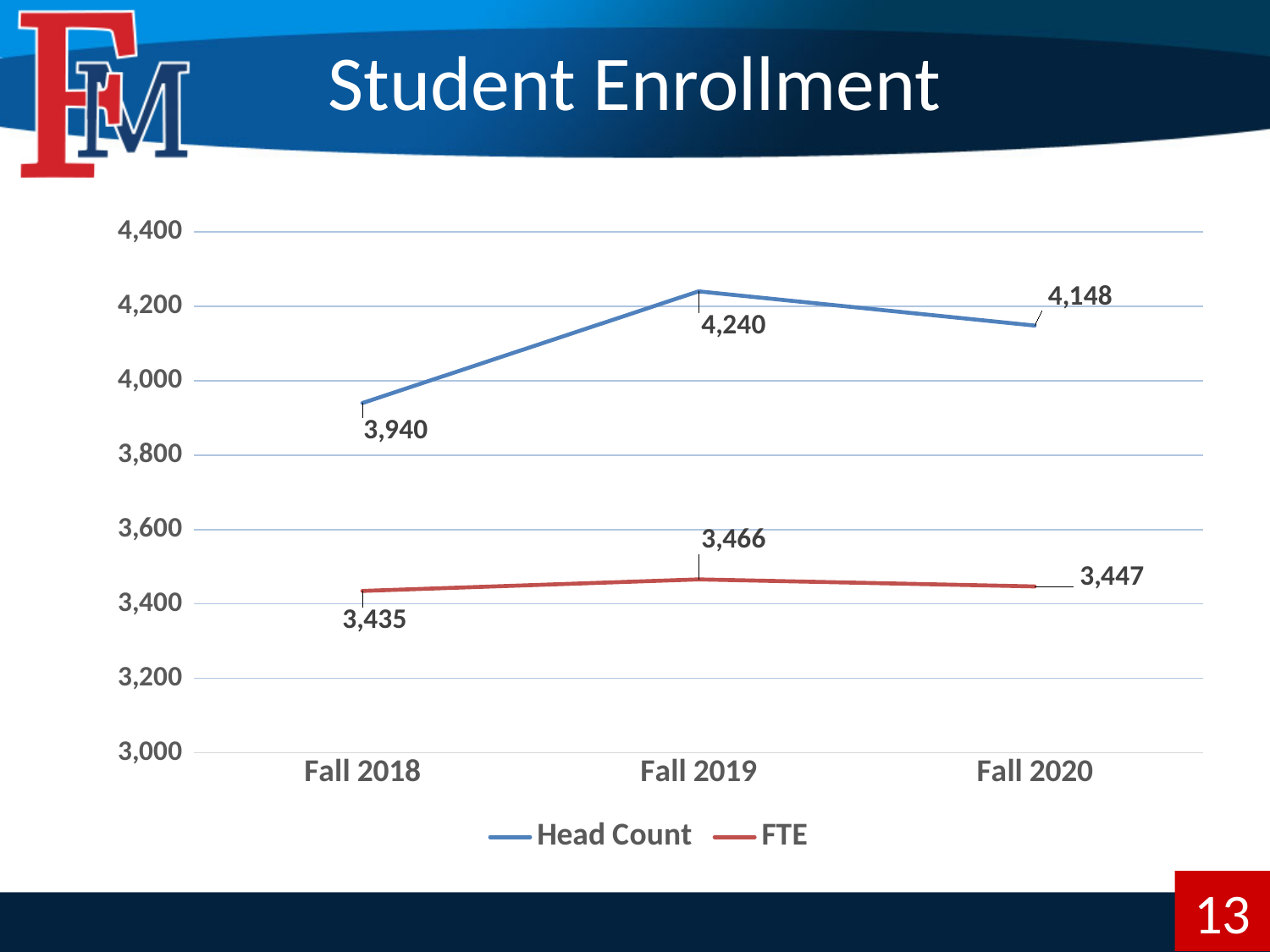
What kind of chart is shown on the slide? line chart How many series does the legend list? 2 What is the Head Count for Fall 2019? 4,240 Which is larger, the Head Count in Fall 2020 or the Head Count in Fall 2018? Fall 2020 What is the FTE value for Fall 2020? 3,447 In which term is the Head Count highest? Fall 2019 What is the difference between the Head Count and FTE in Fall 2020? 701 What is the FTE value for Fall 2018? 3,435 How many terms are shown on the x axis? 3 Is the Head Count for Fall 2018 greater or less than 4,000? less What is the difference between the Head Count in Fall 2019 and Fall 2018? 300 In which term is the FTE lowest? Fall 2018